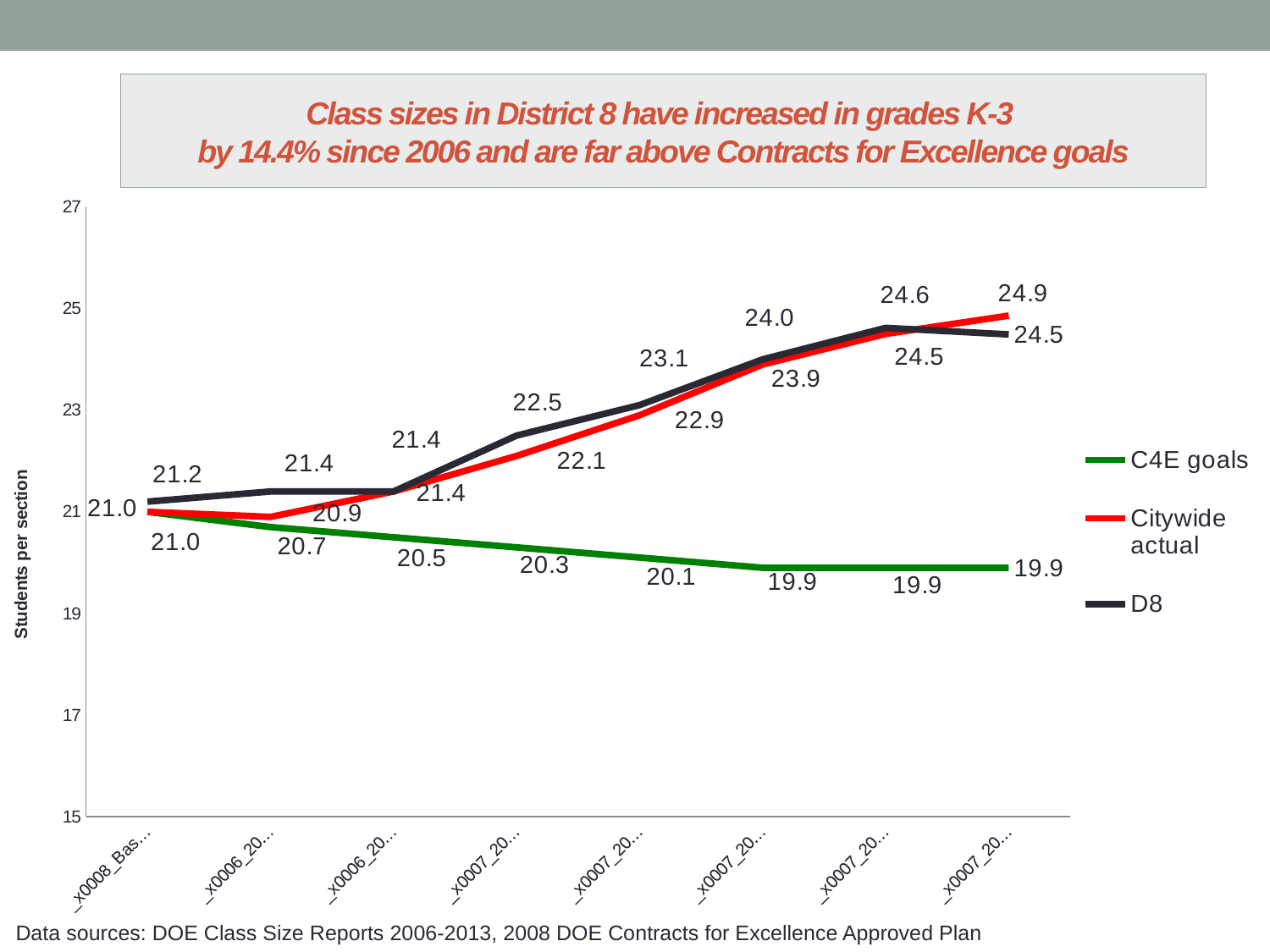
What type of chart is shown on the slide? line chart What is the label on the vertical axis? Students per section At the final point, what is the difference between the D8 value and the C4E goals value? 4.6 What is the value of the D8 line at its final point? 24.5 At the final point, which is higher: Citywide actual or D8? Citywide actual What is the highest value reached by the D8 line? 24.6 How many series does the legend list? 3 What is the lowest value on the C4E goals line? 19.9 Does the C4E goals line rise or fall along the x axis? fall At the final point, what is the difference between the Citywide actual value and the D8 value? 0.4 What is the value of the Citywide actual line at its final point? 24.9 How many data points does each line have? 8